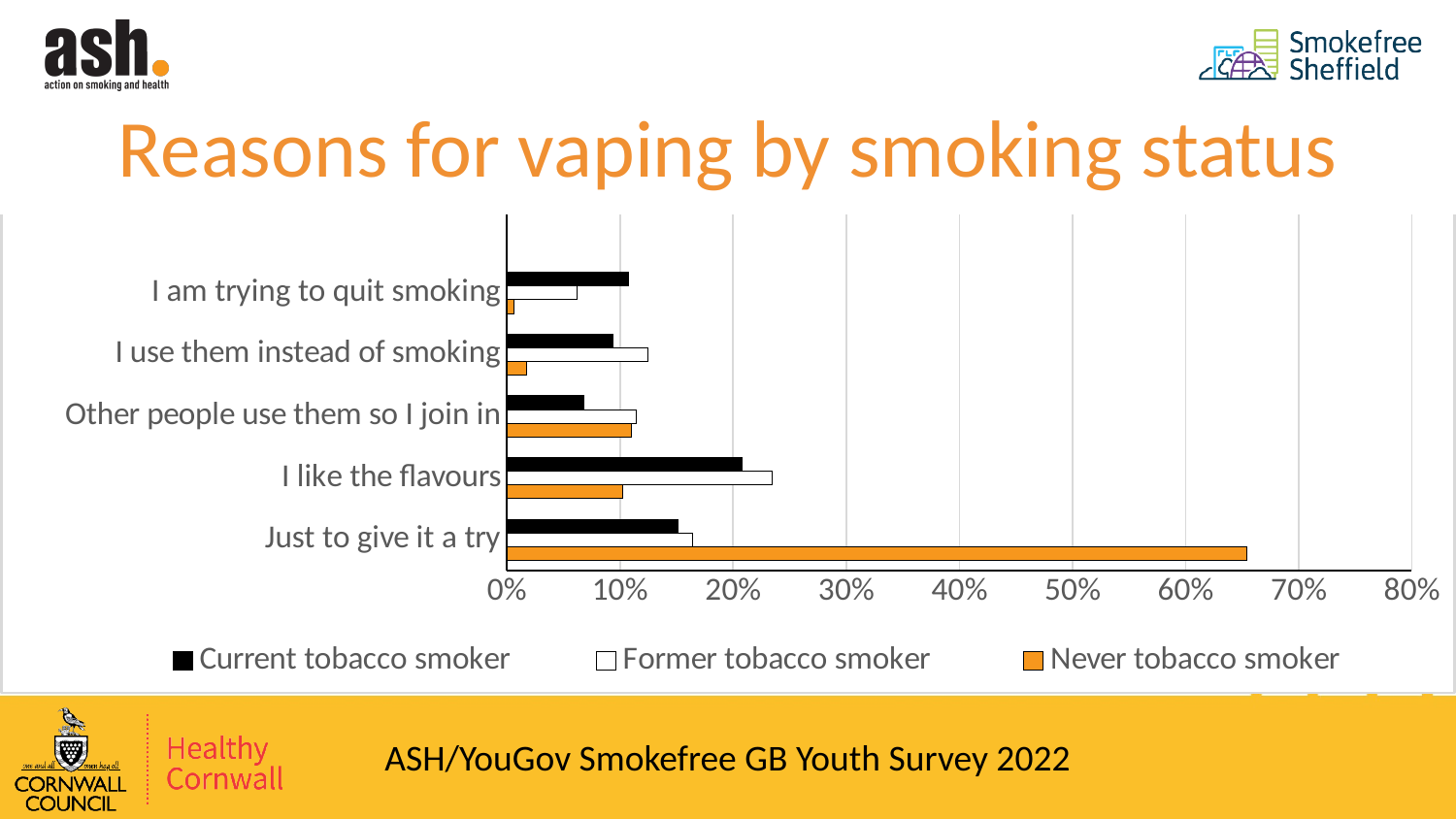
How many reasons (categories) are plotted on the chart? 5 What kind of chart is shown on the slide? Bar chart For Never tobacco smokers, which reason has the lowest value? I am trying to quit smoking Is the Former tobacco smoker value for 'I like the flavours' greater or less than 30%? less For 'I am trying to quit smoking', which is larger: the Current tobacco smoker value or the Never tobacco smoker value? Current tobacco smoker Is the Current tobacco smoker value for 'I like the flavours' greater or less than 10%? greater How many series does the legend list? 3 For Current tobacco smokers, which reason has the highest value? I like the flavours What is the title of the chart on the slide? Reasons for vaping by smoking status For 'I use them instead of smoking', which is larger: the Former tobacco smoker value or the Never tobacco smoker value? Former tobacco smoker For Never tobacco smokers, which reason has the highest value? Just to give it a try Is the Never tobacco smoker value for 'Just to give it a try' greater or less than 60%? greater